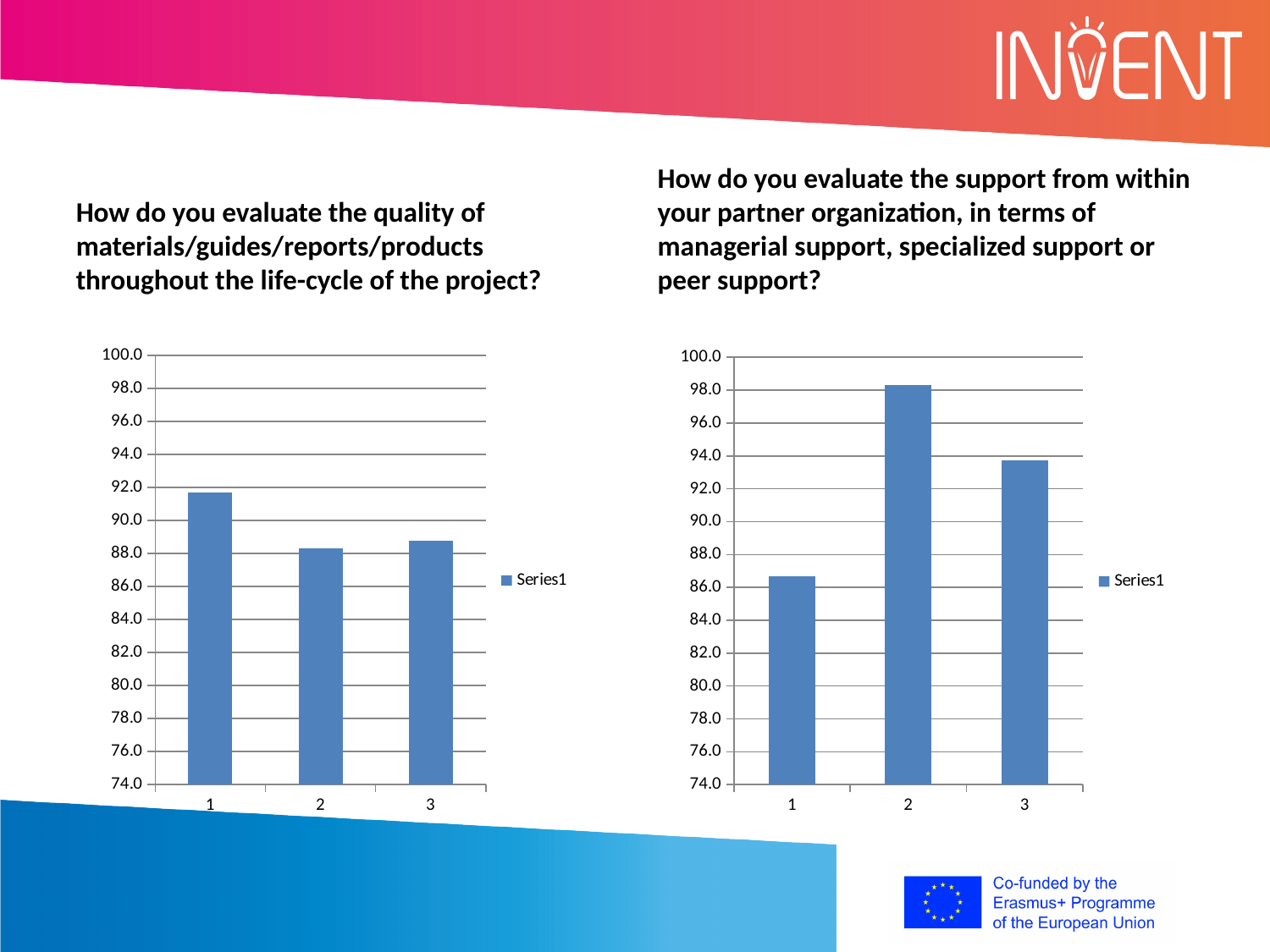
How many series does the legend of the left chart (quality of materials/guides/reports/products) list? 1 On the right chart (support from within your partner organization), is the value for category 3 greater or less than 92.0? greater On the right chart (support from within your partner organization), is the value for category 1 greater or less than 88.0? less On the left chart (quality of materials/guides/reports/products), which category has the highest value? 1 On the left chart (quality of materials/guides/reports/products), is the value for category 2 greater or less than 90.0? less On the left chart (quality of materials/guides/reports/products), which is larger, the value for category 1 or category 2? Category 1 How many categories are shown on the right chart (support from within your partner organization)? 3 On the right chart (support from within your partner organization), which category has the highest value? 2 What kind of chart is the right chart (support from within your partner organization)? Bar chart On the right chart (support from within your partner organization), which category has the lowest value? 1